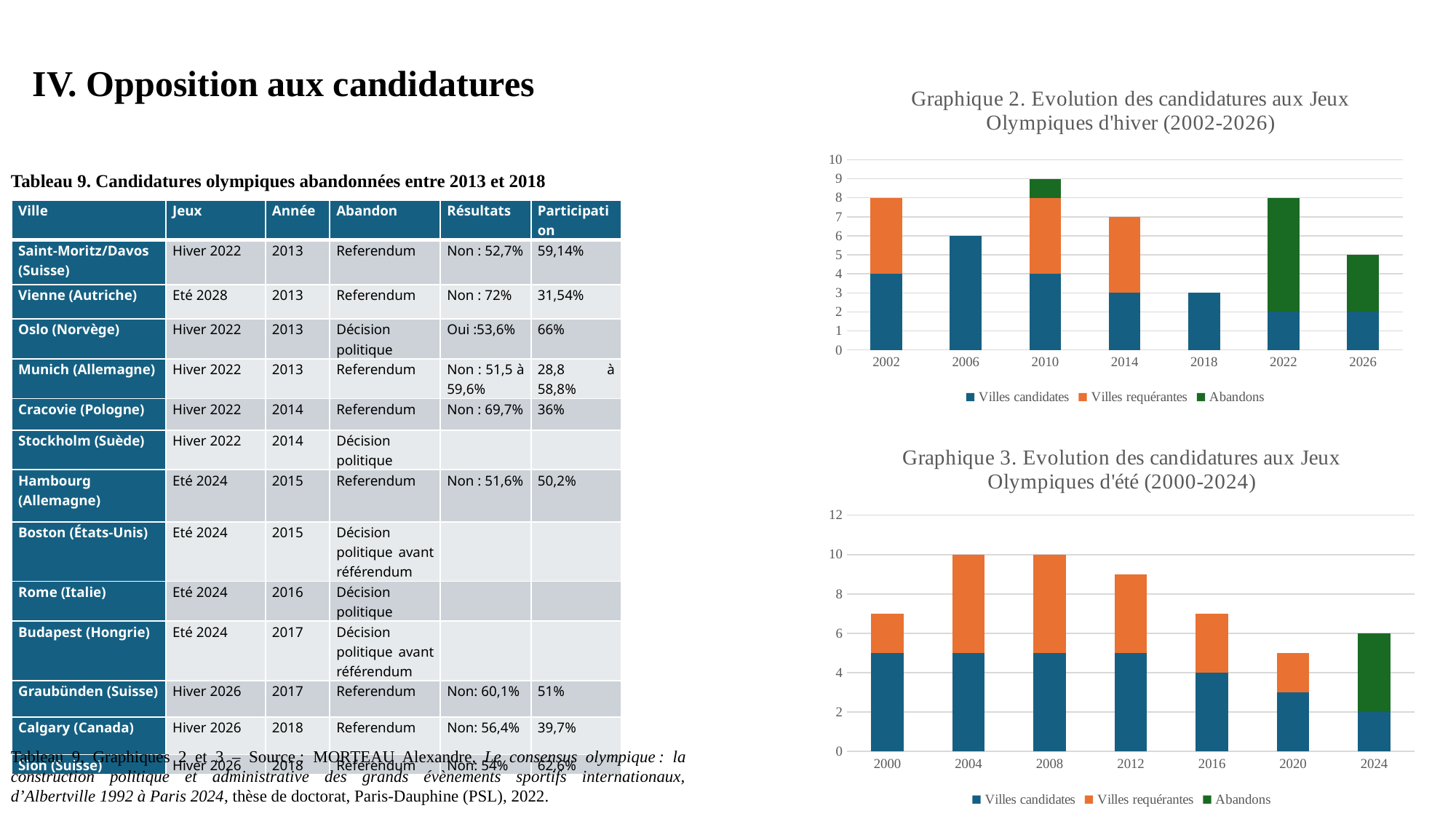
In Graphique 3, which year has the lowest total bar? 2020 In Graphique 3, is the total bar for 2004 larger or smaller than the total bar for 2016? larger How many series does the legend of Graphique 3 list? 3 In Graphique 2, what is the value of Villes candidates for 2006? 6 In Graphique 2, what is the total height of the stacked bar for 2010? 9 In Graphique 3, is the total bar for 2024 greater or less than 8? less What kind of chart is Graphique 2? bar chart How many years are shown on the x axis of Graphique 2? 7 In Graphique 2, which year has the lowest total bar? 2018 In Graphique 2, what colour represents Abandons in the legend? green